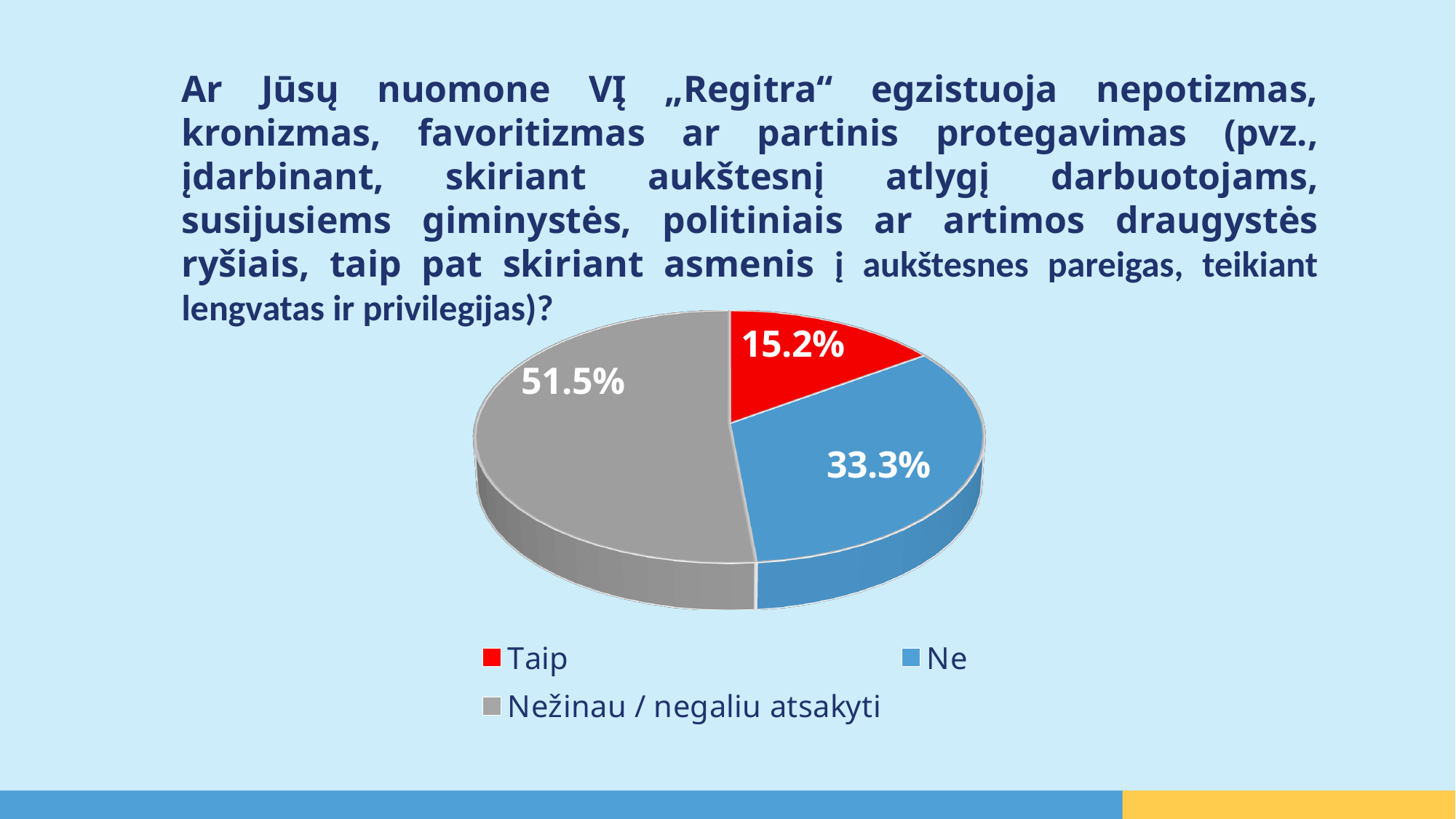
Which answer has the largest share of the pie? Nežinau / negaliu atsakyti Which is larger, the share for "Ne" or the share for "Taip"? Ne What kind of chart is shown on the slide? Pie chart What colour is the slice for "Taip"? Red Which legend entry is shown in grey? Nežinau / negaliu atsakyti What share of respondents answered "Taip"? 15.2% Which answer has the smallest share of the pie? Taip What is the difference in percentage points between the "Nežinau / negaliu atsakyti" and "Ne" shares? 18.2 What share of respondents answered "Ne"? 33.3% What is the difference in percentage points between the "Ne" and "Taip" shares? 18.1 What share of respondents answered "Nežinau / negaliu atsakyti"? 51.5% How many slices does the pie chart have? 3